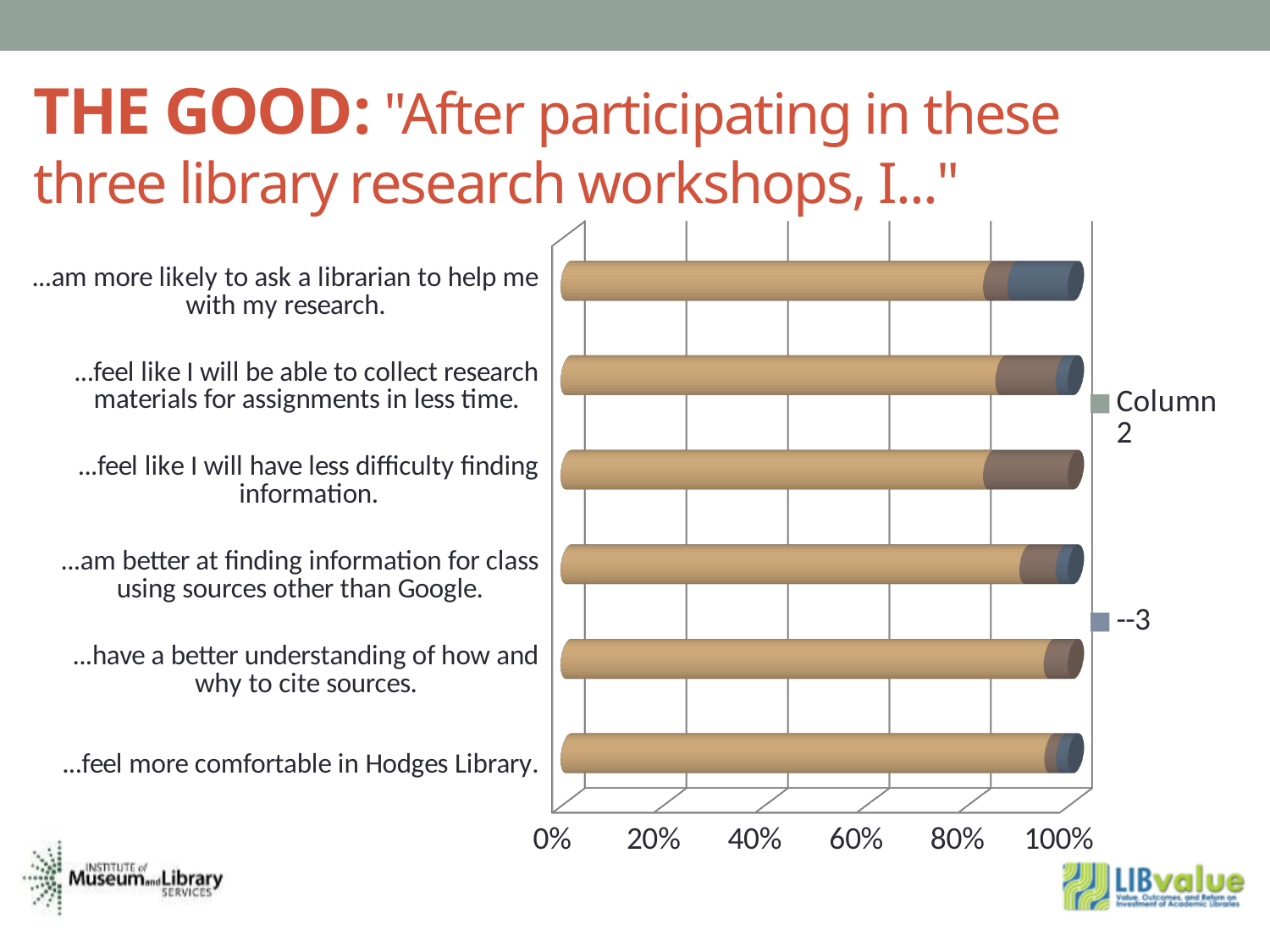
Which category is listed at the bottom of the chart? ...feel more comfortable in Hodges Library. Which has the larger brown (middle) segment: "...feel like I will have less difficulty finding information." or "...feel more comfortable in Hodges Library."? ...feel like I will have less difficulty finding information. Is the tan (first) segment for "...am more likely to ask a librarian to help me with my research." greater or less than 60%? greater Is the tan (first) segment for "...have a better understanding of how and why to cite sources." greater or less than 80%? greater Which has the larger tan (first) segment: "...feel more comfortable in Hodges Library." or "...am more likely to ask a librarian to help me with my research."? ...feel more comfortable in Hodges Library. What kind of chart is shown on the slide? bar chart How many statement categories are plotted in the chart? 6 Which category has the largest brown (middle) segment? ...feel like I will have less difficulty finding information. Is the tan (first) segment for "...feel more comfortable in Hodges Library." greater or less than 80%? greater What is the highest value shown on the horizontal axis? 100% Which category has the largest blue-gray (last) segment? ...am more likely to ask a librarian to help me with my research.